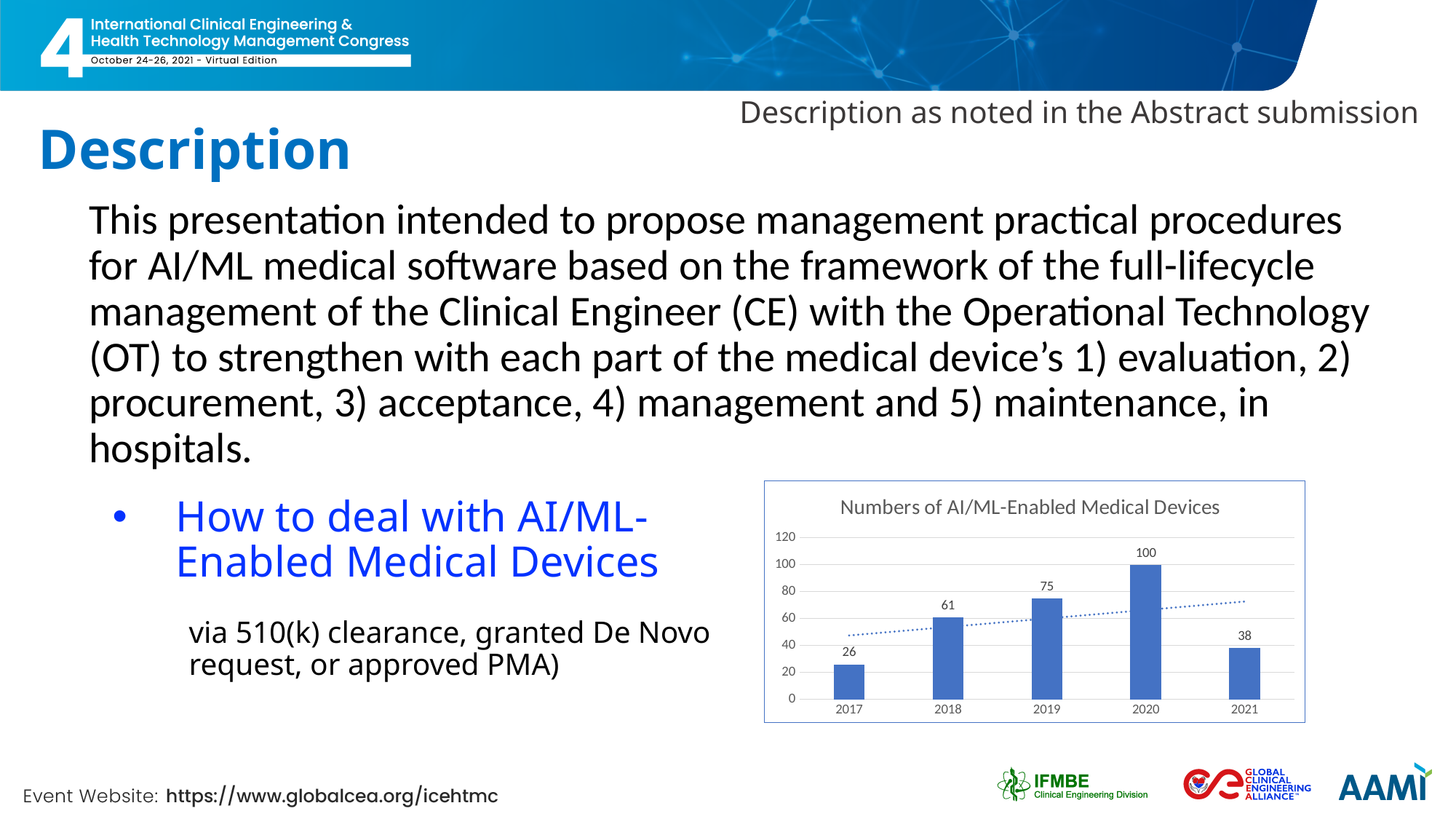
How many years are shown on the x axis of the chart? 5 Which year has the highest number of AI/ML-enabled medical devices? 2020 Which year has the lowest number of AI/ML-enabled medical devices? 2017 What is the value for 2020 in the chart? 100 What is the difference between the values for 2020 and 2019? 25 What is the value for 2021 in the chart? 38 Which is larger, the value for 2019 or the value for 2021? 2019 Is the value for 2018 greater or less than 40? greater What is the value for 2017 in the chart? 26 What is the difference between the values for 2018 and 2017? 35 What kind of chart is shown on the slide? bar chart What is the title of the chart? Numbers of AI/ML-Enabled Medical Devices